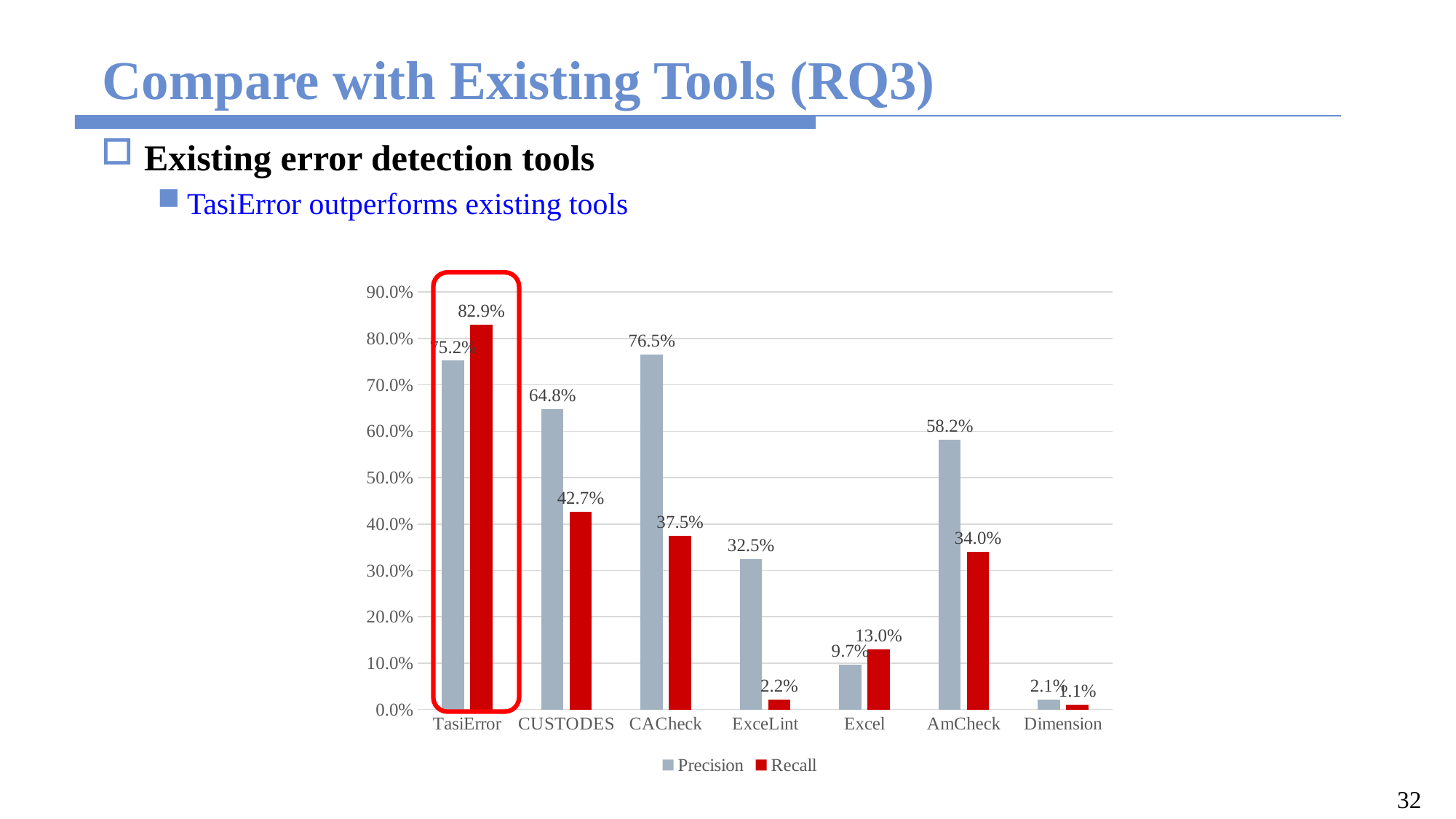
Which is larger for Excel, Precision or Recall? Recall What is the difference between the Precision and Recall values for CUSTODES? 22.1% Is the Recall value for CACheck greater or less than 40.0%? less What is the Recall value for TasiError? 82.9% What is the Precision value for CACheck? 76.5% What is the Precision value for AmCheck? 58.2% Which tool has the highest Recall? TasiError What is the Recall value for ExceLint? 2.2% Which tool has the lowest Precision? Dimension What kind of chart is shown on the slide? Bar chart How many series does the legend list? 2 How many tools are shown on the x axis of the chart? 7